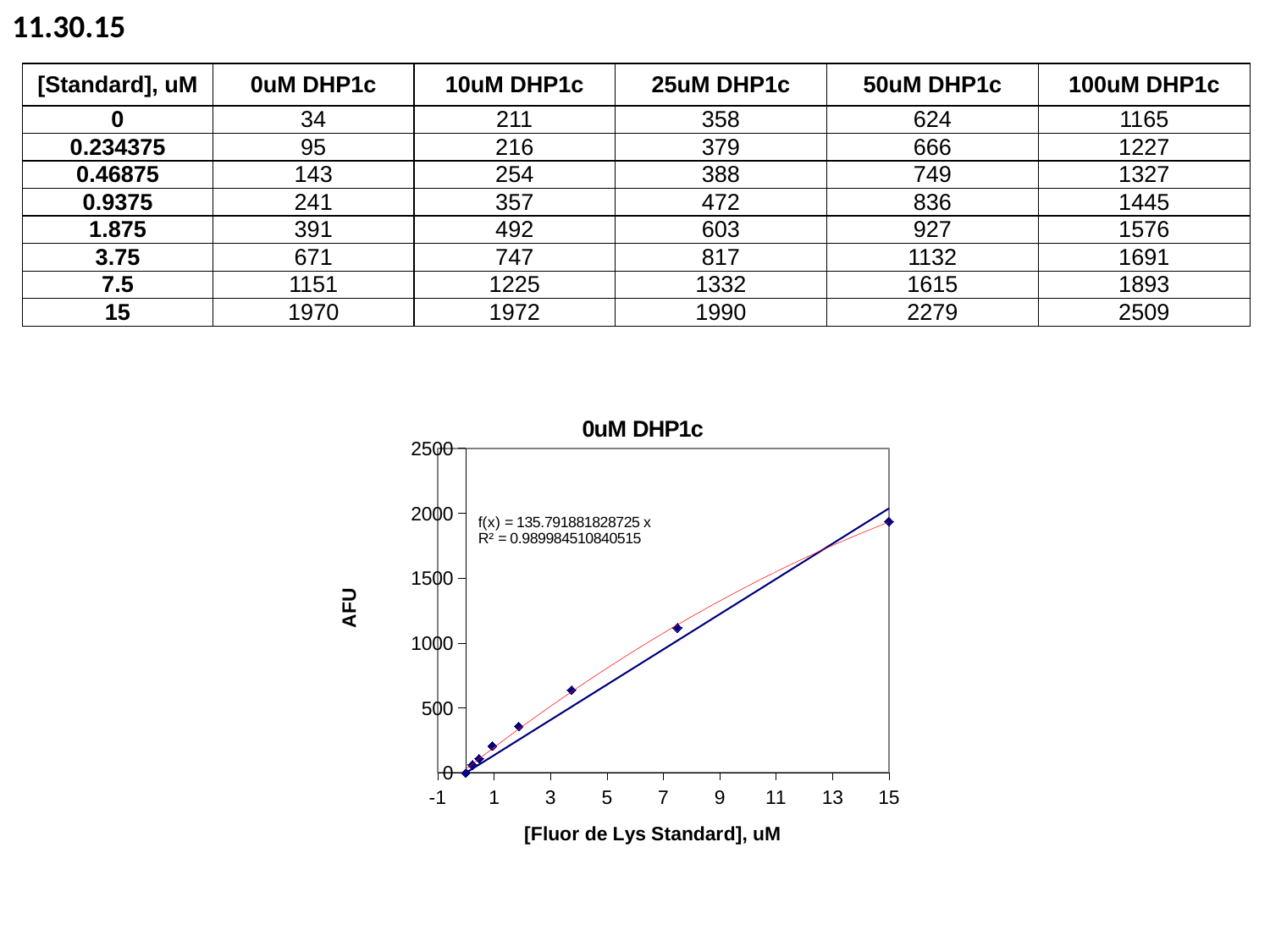
What kind of chart is shown on the slide? scatter chart Is the AFU value at 3.75 uM greater or less than 1000? less Is the AFU value at 7.5 uM greater or less than 1000? greater According to the table, what is the AFU value for 0uM DHP1c at a standard concentration of 15 uM? 1970 What is the slope of the fitted line f(x) shown on the chart? 135.791881828725 What is the title of the chart? 0uM DHP1c What R² value is shown on the chart? 0.989984510840515 How many data points are plotted in the chart? 8 What is the label of the y axis of the chart? AFU At which standard concentration is the plotted AFU value highest? 15 Is the AFU value at 15 uM greater or less than 1500? greater Do the AFU values rise or fall as the standard concentration increases along the x axis? rise